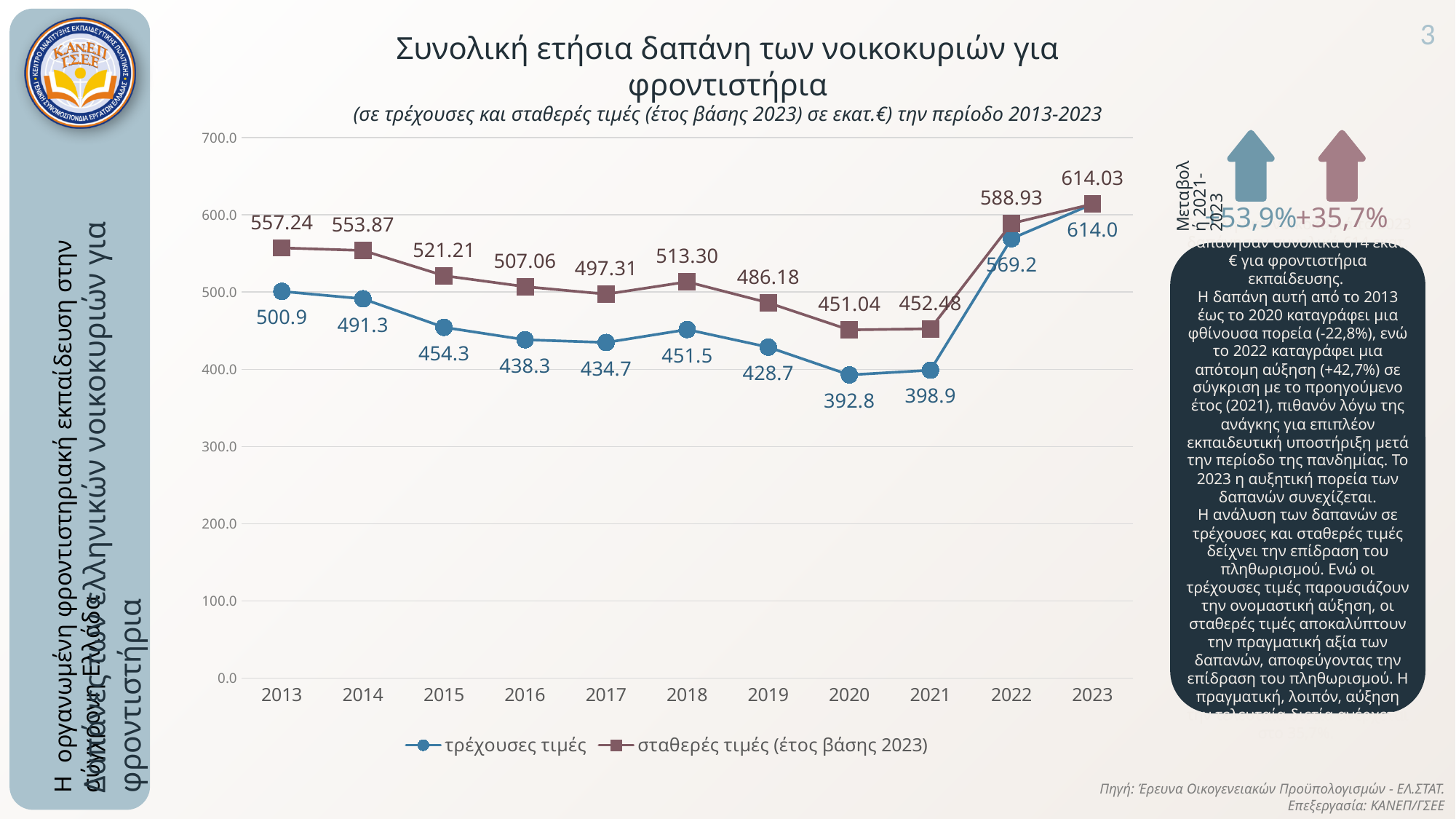
What is the difference between the σταθερές τιμές value in 2013 and the τρέχουσες τιμές value in 2013? 56.34 What is the percentage change shown next to the blue arrow at the right of the chart? +53,9% In which year is the τρέχουσες τιμές series at its lowest? 2020 In which year is the σταθερές τιμές (έτος βάσης 2023) series at its highest? 2023 Which is larger in 2018: the τρέχουσες τιμές value or the σταθερές τιμές value? σταθερές τιμές How many years are plotted on the x axis? 11 What is the value for τρέχουσες τιμές in 2022? 569.2 Does the τρέχουσες τιμές series rise or fall from 2013 to 2020? fall What is the value for σταθερές τιμές (έτος βάσης 2023) in 2015? 521.21 How many series does the legend list? 2 What type of chart is shown on the slide? line chart What is the value for τρέχουσες τιμές in 2020? 392.8